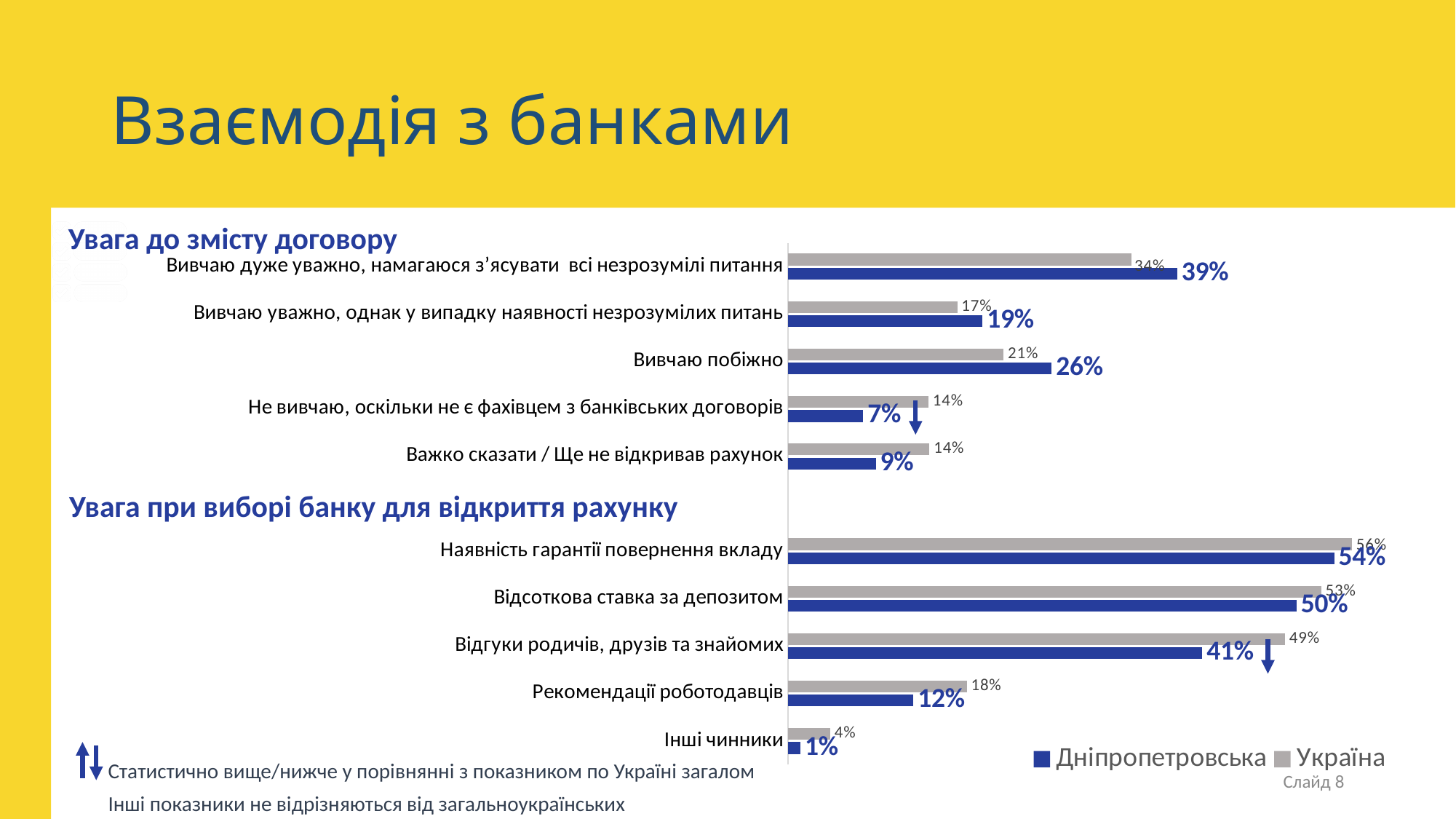
In the section "Увага до змісту договору", which category has the lowest value for Дніпропетровська? Не вивчаю, оскільки не є фахівцем з банківських договорів What is the value for Україна for "Наявність гарантії повернення вкладу"? 56% For "Вивчаю побіжно", which is larger: the Дніпропетровська value or the Україна value? Дніпропетровська What is the value for Дніпропетровська for "Вивчаю дуже уважно, намагаюся з'ясувати всі незрозумілі питання"? 39% What is the value for Дніпропетровська for "Рекомендації роботодавців"? 12% How many categories are shown in the section "Увага при виборі банку для відкриття рахунку"? 5 What kind of chart is shown on the slide? Bar chart How many series does the legend list? 2 For "Не вивчаю, оскільки не є фахівцем з банківських договорів", which is larger: the Дніпропетровська value or the Україна value? Україна What is the value for Україна for "Вивчаю побіжно"? 21% In the section "Увага при виборі банку для відкриття рахунку", which category has the highest value for Дніпропетровська? Наявність гарантії повернення вкладу What is the difference between the Україна and Дніпропетровська values for "Відгуки родичів, друзів та знайомих"? 8%